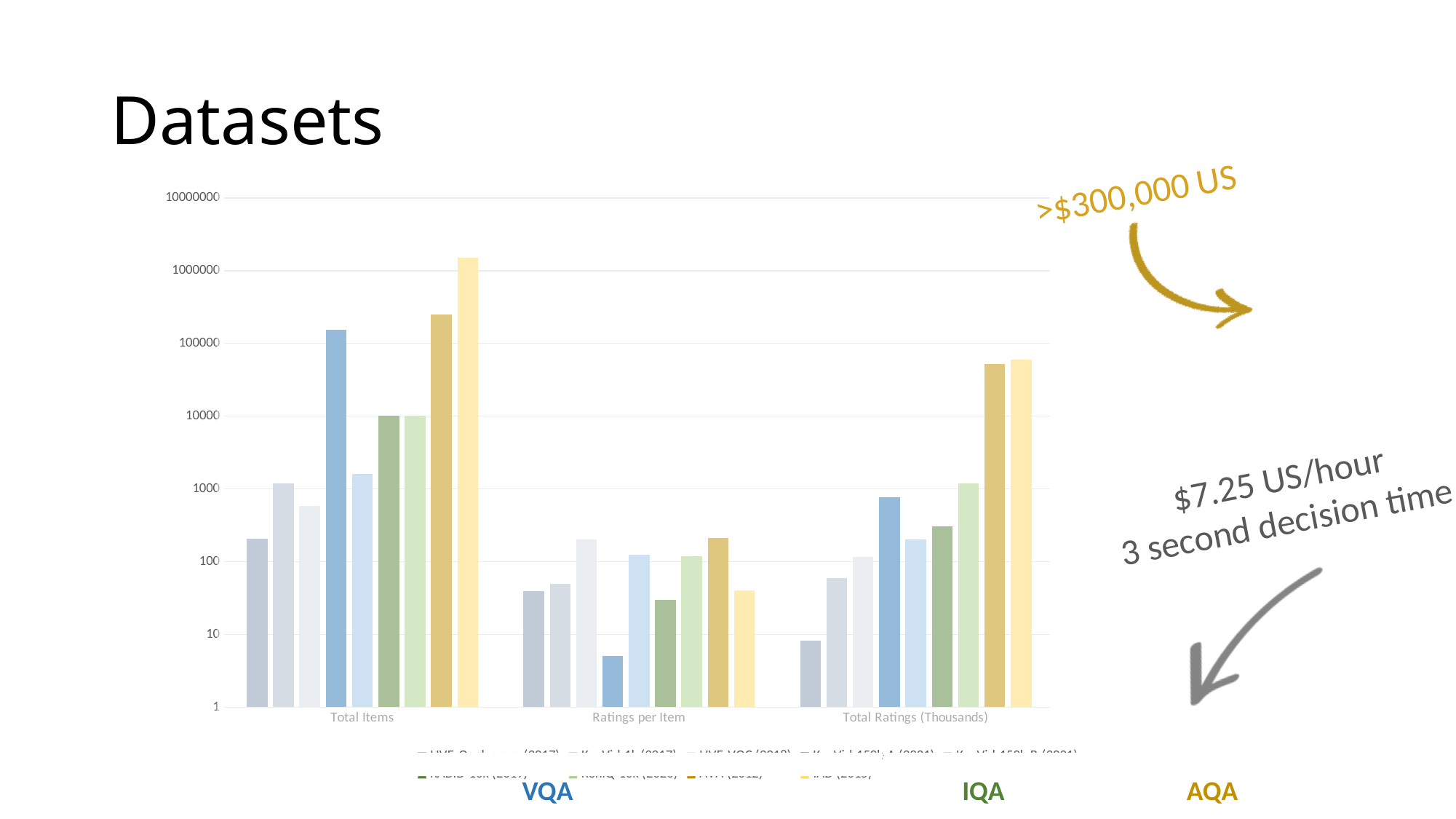
Is the shortest bar in the Ratings per Item category greater or less than 10? less Which category has a taller tallest bar: Ratings per Item or Total Ratings (Thousands)? Total Ratings (Thousands) Which category on the x axis contains the tallest bar in the chart? Total Items Is the tallest bar in the Total Items category greater or less than 1000000? greater How many bars are plotted in the Total Items category? 9 How many categories are shown on the x axis of the chart? 3 What is the label of the middle category on the x axis? Ratings per Item Is the tallest bar in the Total Ratings (Thousands) category greater or less than 100000? less What type of chart is shown on the slide? bar chart What is the highest value labelled on the y axis of the chart? 10000000